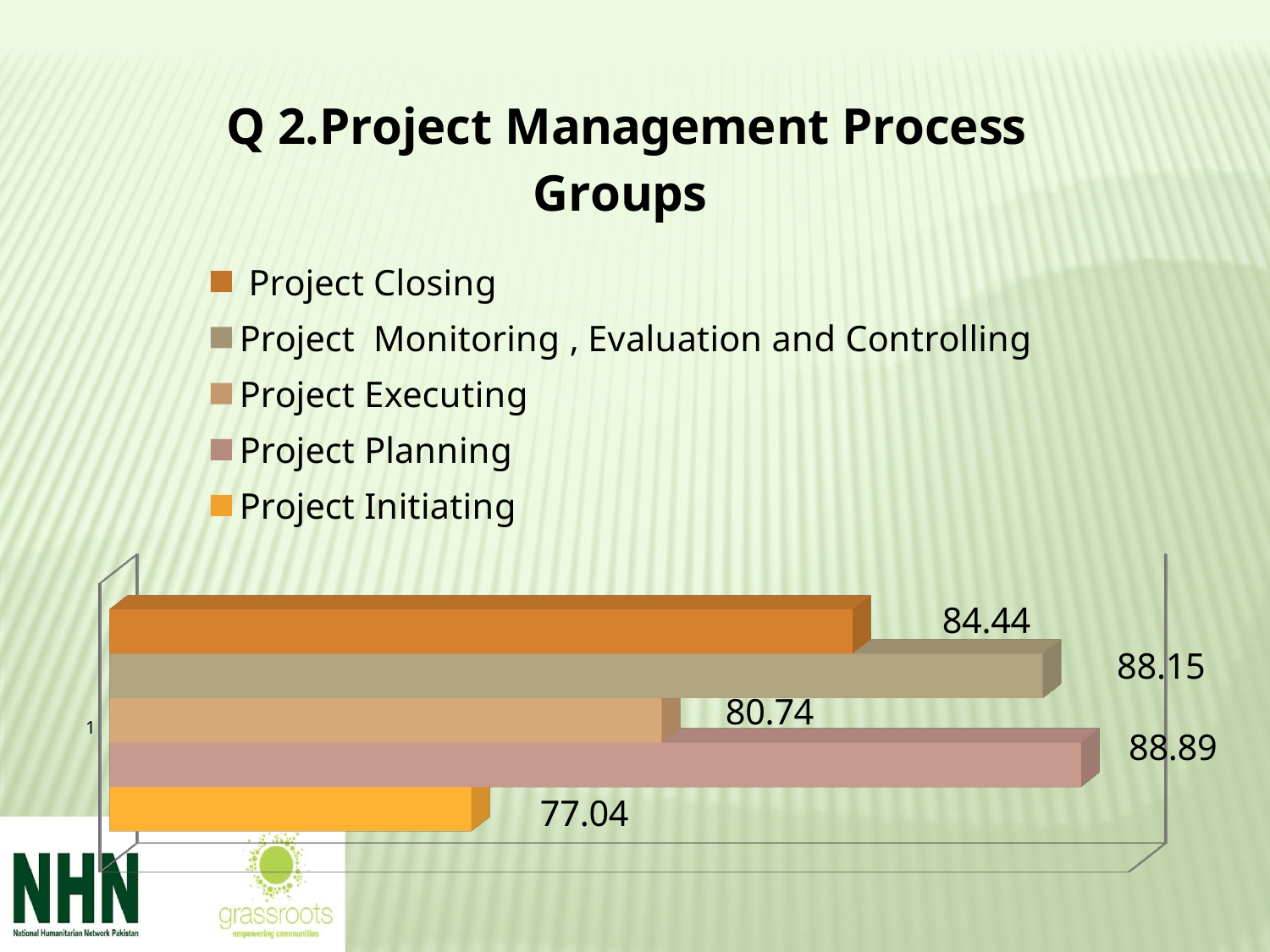
What kind of chart is shown on the slide? Bar chart What is the value for Project Monitoring, Evaluation and Controlling? 88.15 Which is larger, the value for Project Closing or the value for Project Executing? Project Closing What is the value for Project Executing? 80.74 What is the difference between the values for Project Monitoring, Evaluation and Controlling and Project Closing? 3.71 What is the value for Project Initiating? 77.04 What is the value for Project Planning? 88.89 Which series has the highest value? Project Planning How many series does the legend list? 5 What is the difference between the values for Project Planning and Project Initiating? 11.85 What is the value for Project Closing? 84.44 Which series has the lowest value? Project Initiating